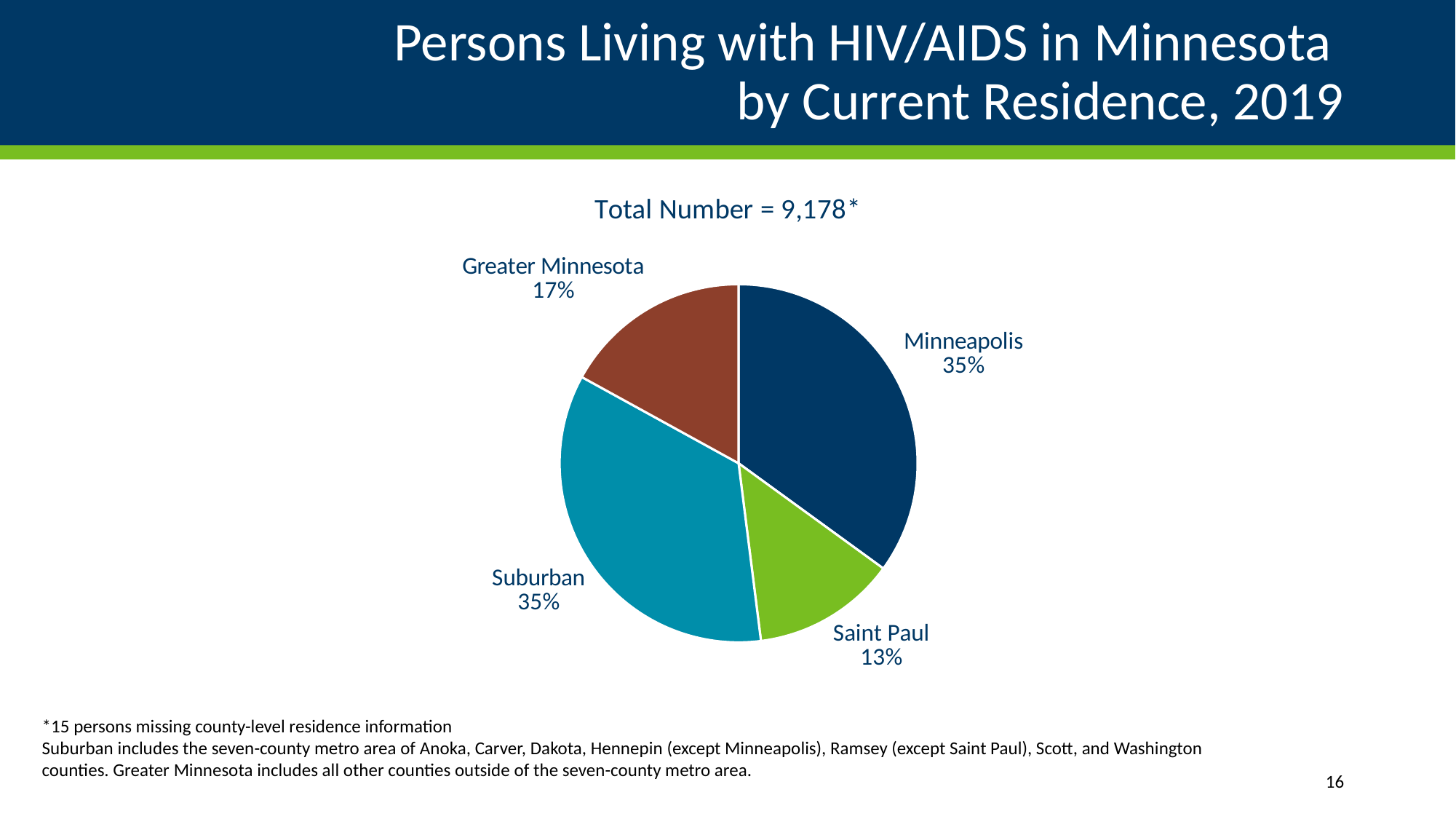
What kind of chart is shown on the slide? Pie chart What percentage is shown for Greater Minnesota? 17% What total number is stated above the pie chart? 9,178 Which residence category has the smallest share of the pie? Saint Paul How many residence categories are shown in the pie chart? 4 What percentage is shown for the Suburban slice? 35% What percentage of the pie is labelled Saint Paul? 13% What colour is the Saint Paul slice of the pie? Green Which is larger, the share for Greater Minnesota or the share for Saint Paul? Greater Minnesota How many percentage points larger is the Minneapolis share than the Saint Paul share? 22 percentage points What share of persons living with HIV/AIDS in Minnesota reside in Minneapolis? 35% How many percentage points larger is the Greater Minnesota share than the Saint Paul share? 4 percentage points